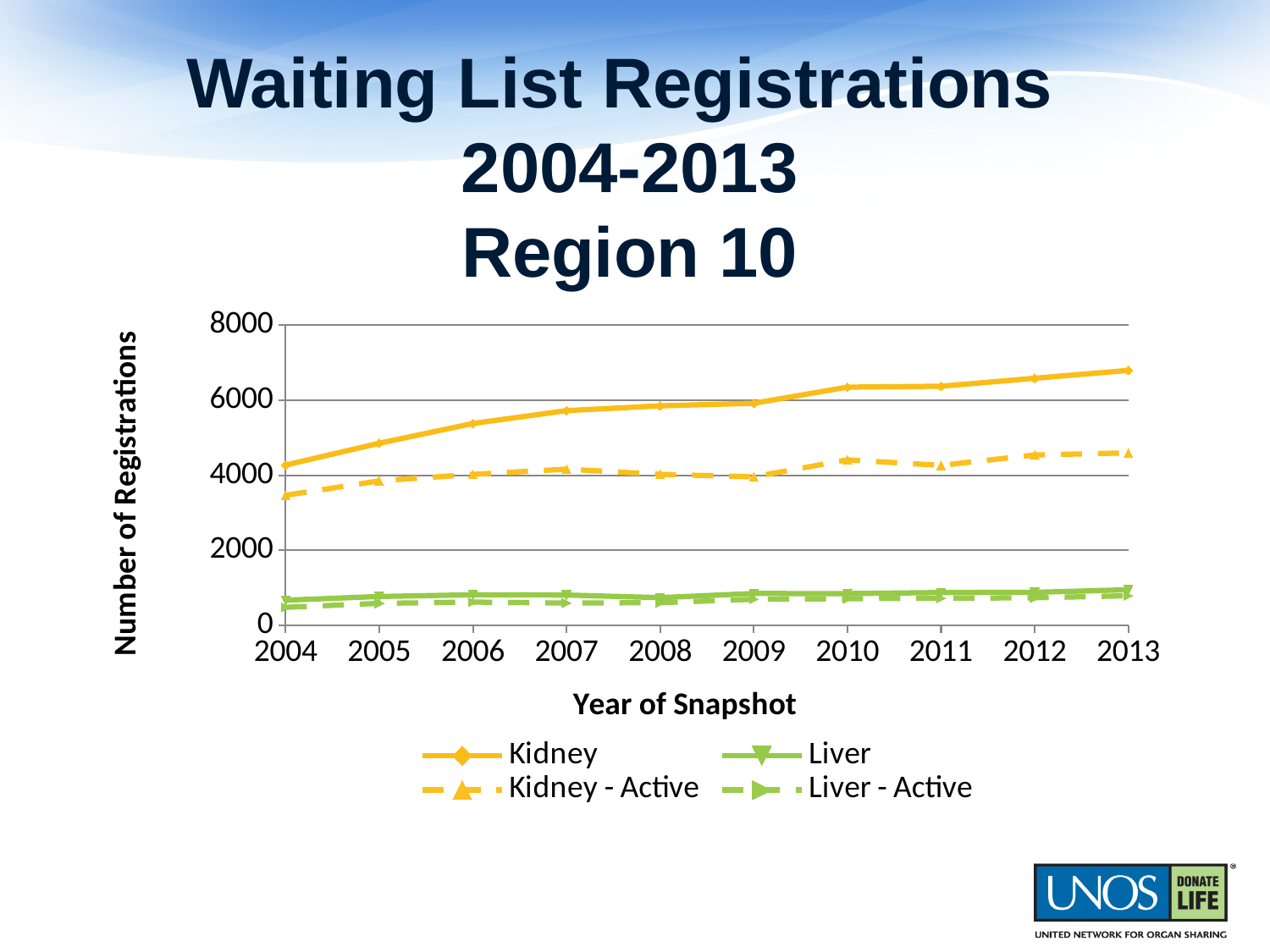
Is the Liver value for 2013 greater or less than 2000? less What is the title of the x axis? Year of Snapshot How many years are plotted along the x axis? 10 Which series has the lowest values across the chart? Liver - Active Is the Kidney - Active value for 2004 greater or less than 4000? less In 2013, which is larger: the Kidney value or the Liver value? Kidney Does the Kidney series rise or fall from 2004 to 2013? rise Is the Kidney value for 2013 greater or less than 6000? greater What kind of chart is shown on the slide? line chart Which series has the highest values across the chart? Kidney How many series does the legend list? 4